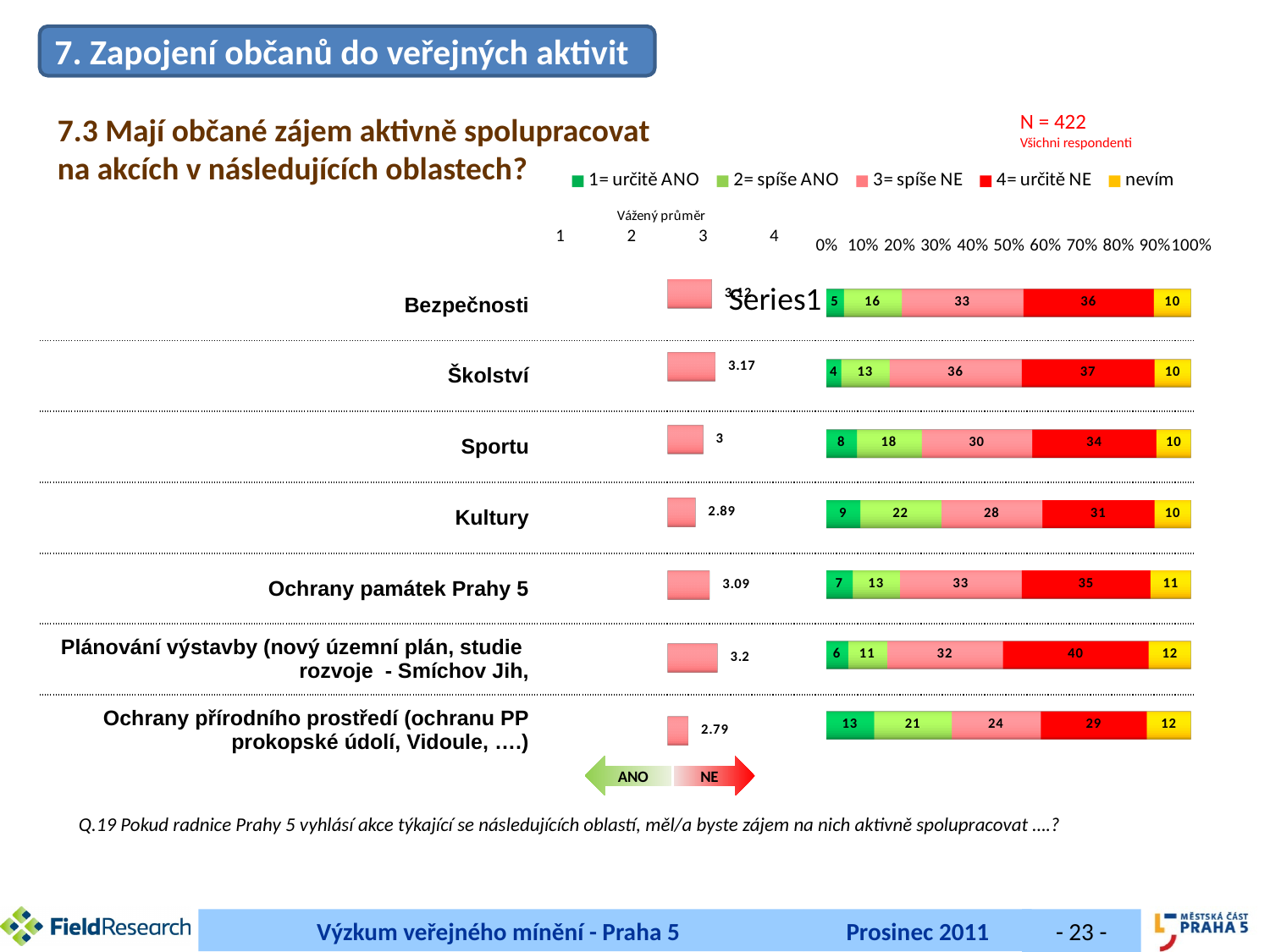
In the Vážený průměr chart, which category has the lowest weighted average? Ochrany přírodního prostředí In the Vážený průměr chart, which category has the highest weighted average? Plánování výstavby In the stacked bar chart, what is the difference between the "4= určitě NE" values for Plánování výstavby and Kultury? 9 What type of chart is the chart on the right side of the slide? Stacked bar chart In the Vážený průměr chart, what is the weighted average for Školství? 3.17 In the stacked bar chart, what is the value for "1= určitě ANO" for Ochrany přírodního prostředí? 13 How many categories are shown in the stacked bar chart? 7 In the stacked bar chart, what percentage of respondents answered "4= určitě NE" for Plánování výstavby? 40 In the stacked bar chart, which category has the highest share of "1= určitě ANO"? Ochrany přírodního prostředí In the stacked bar chart, is the "3= spíše NE" value larger for Školství or for Sportu? Školství In the stacked bar chart, what is the total of the "1= určitě ANO" and "2= spíše ANO" values for Kultury? 31 How many series does the legend of the stacked bar chart list? 5